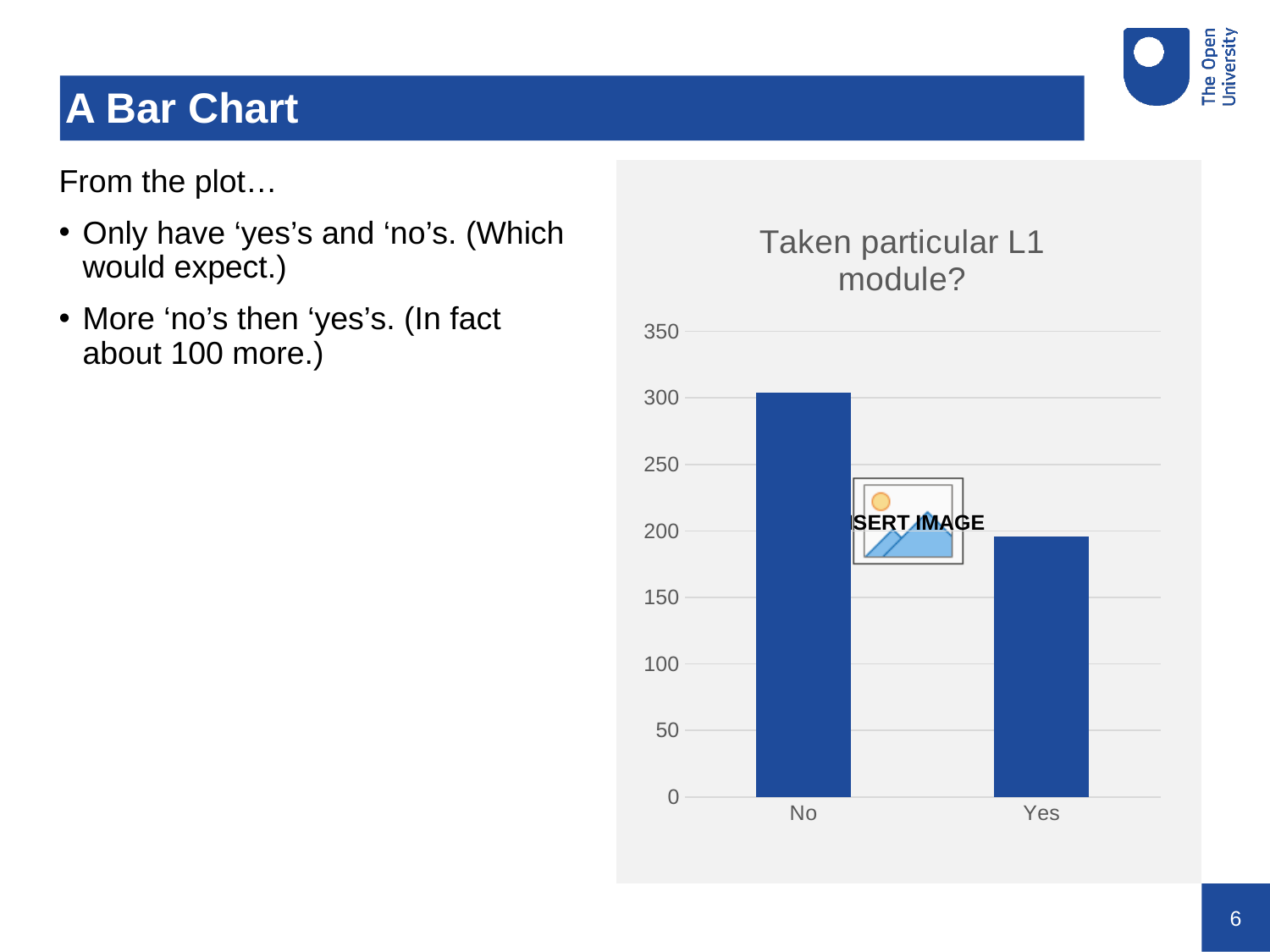
Which is larger, the value for No or the value for Yes? No Is the value for No greater or less than 250? greater Is the value for No greater or less than 350? less Do the bar values rise or fall going from No to Yes along the x axis? fall Which category has the lowest bar in the chart? Yes Is the value for Yes greater or less than 250? less Which category has the highest bar in the chart? No What is the highest tick value shown on the vertical axis of the chart? 350 What kind of chart is shown on the slide? bar chart What is the title of the chart? Taken particular L1 module? How many categories are shown on the x axis of the chart? 2